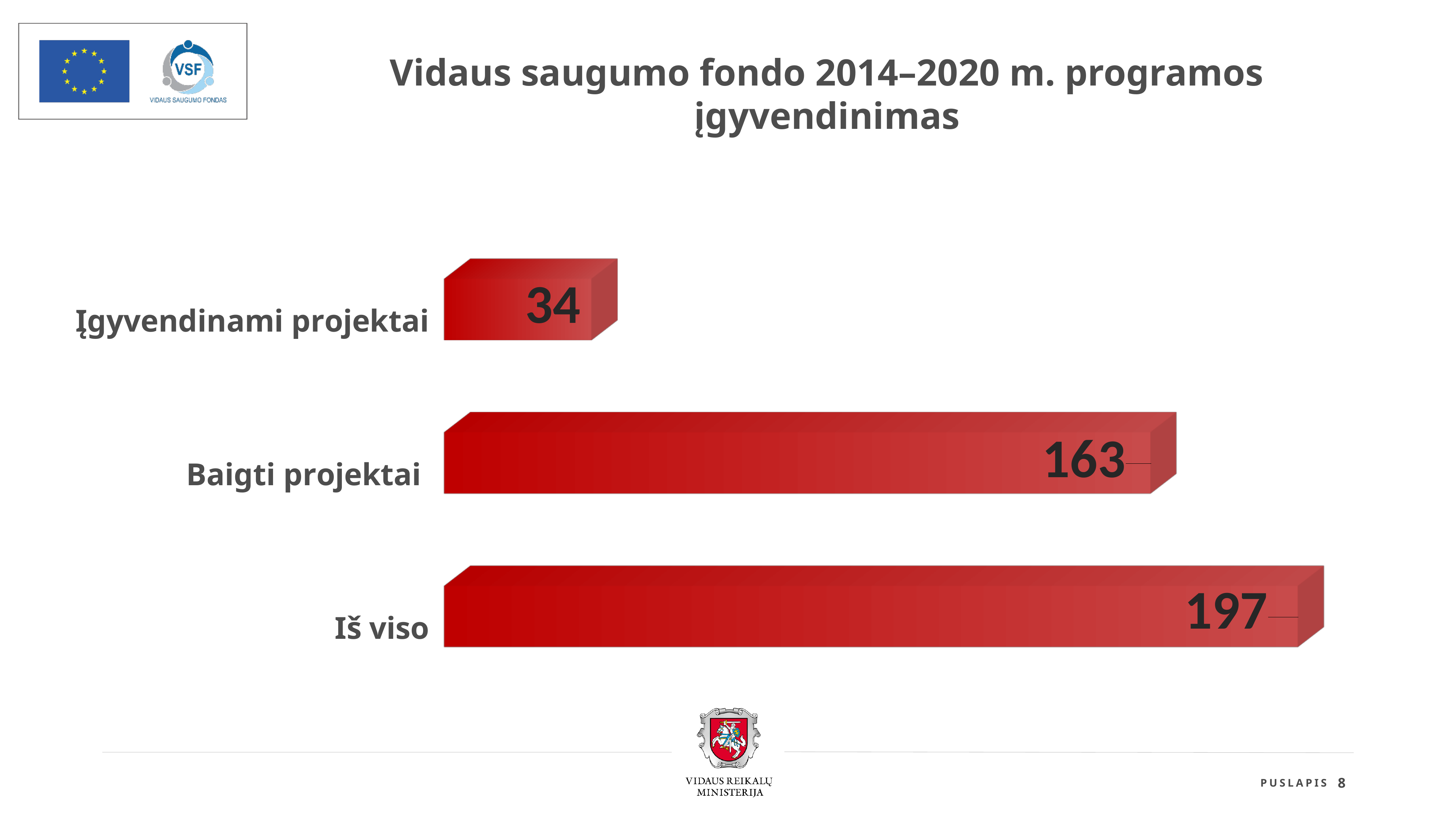
Which category has the highest value? Iš viso What kind of chart is shown on the slide? Bar chart What is the value for Baigti projektai? 163 Which is larger, the value for Baigti projektai or the value for Įgyvendinami projektai? Baigti projektai What is the value for Įgyvendinami projektai? 34 Which category has the lowest value? Įgyvendinami projektai What is the difference between the values for Iš viso and Baigti projektai? 34 What colour are the bars in the chart? Red How many categories are shown in the chart? 3 What is the difference between the values for Baigti projektai and Įgyvendinami projektai? 129 What is the title of the slide containing the chart? Vidaus saugumo fondo 2014–2020 m. programos įgyvendinimas What is the value for Iš viso? 197